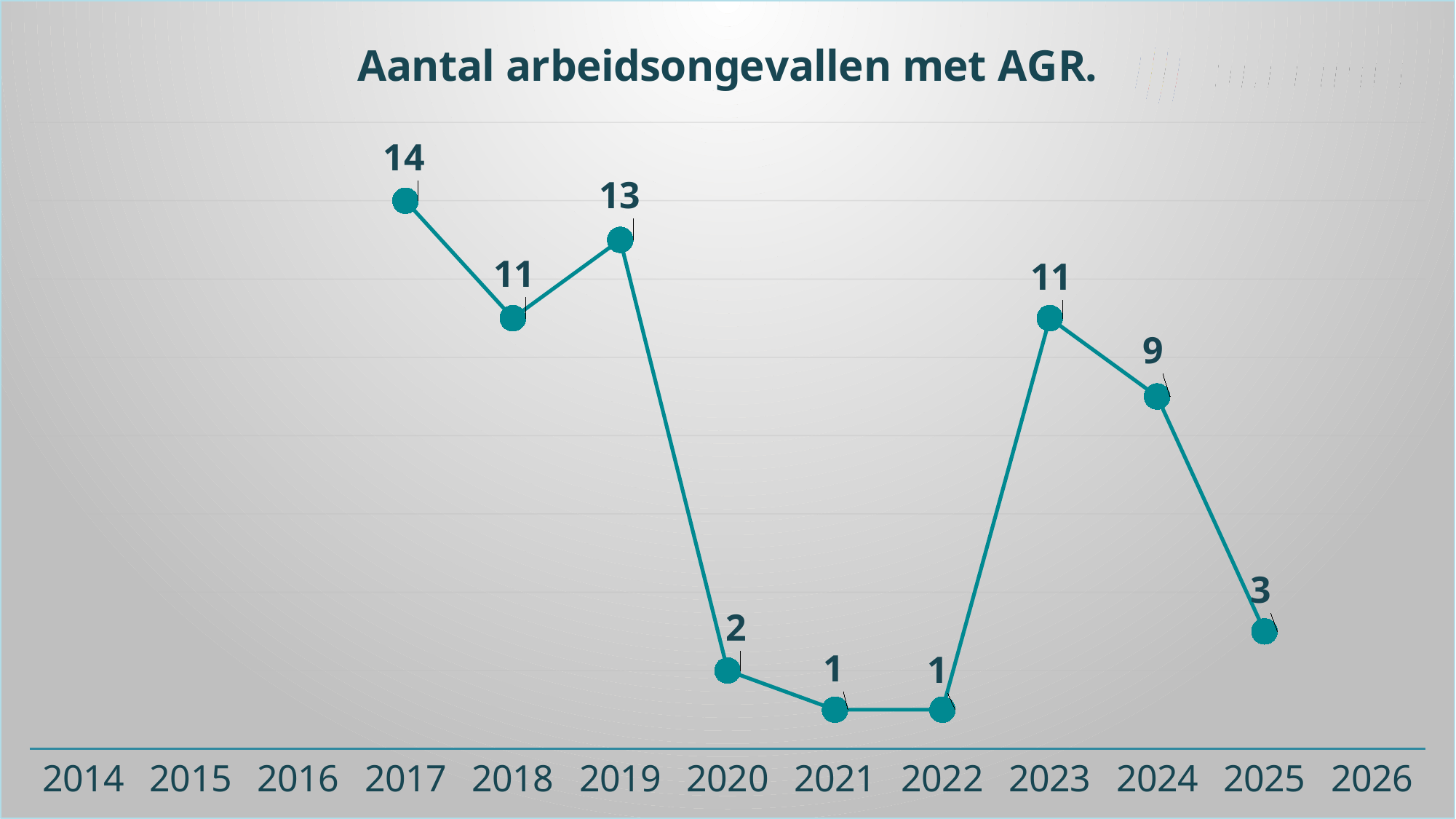
How many data points are plotted on the chart? 9 What is the lowest value plotted on the chart? 1 What is the value for 2025? 3 What is the difference between the values for 2023 and 2024? 2 What is the value for 2024? 9 Which is larger, the value for 2018 or the value for 2024? 2018 What is the title of the chart? Aantal arbeidsongevallen met AGR. Which year has the highest value? 2017 What kind of chart is shown? line chart What is the value for 2017? 14 What is the value for 2019? 13 What is the difference between the values for 2019 and 2020? 11